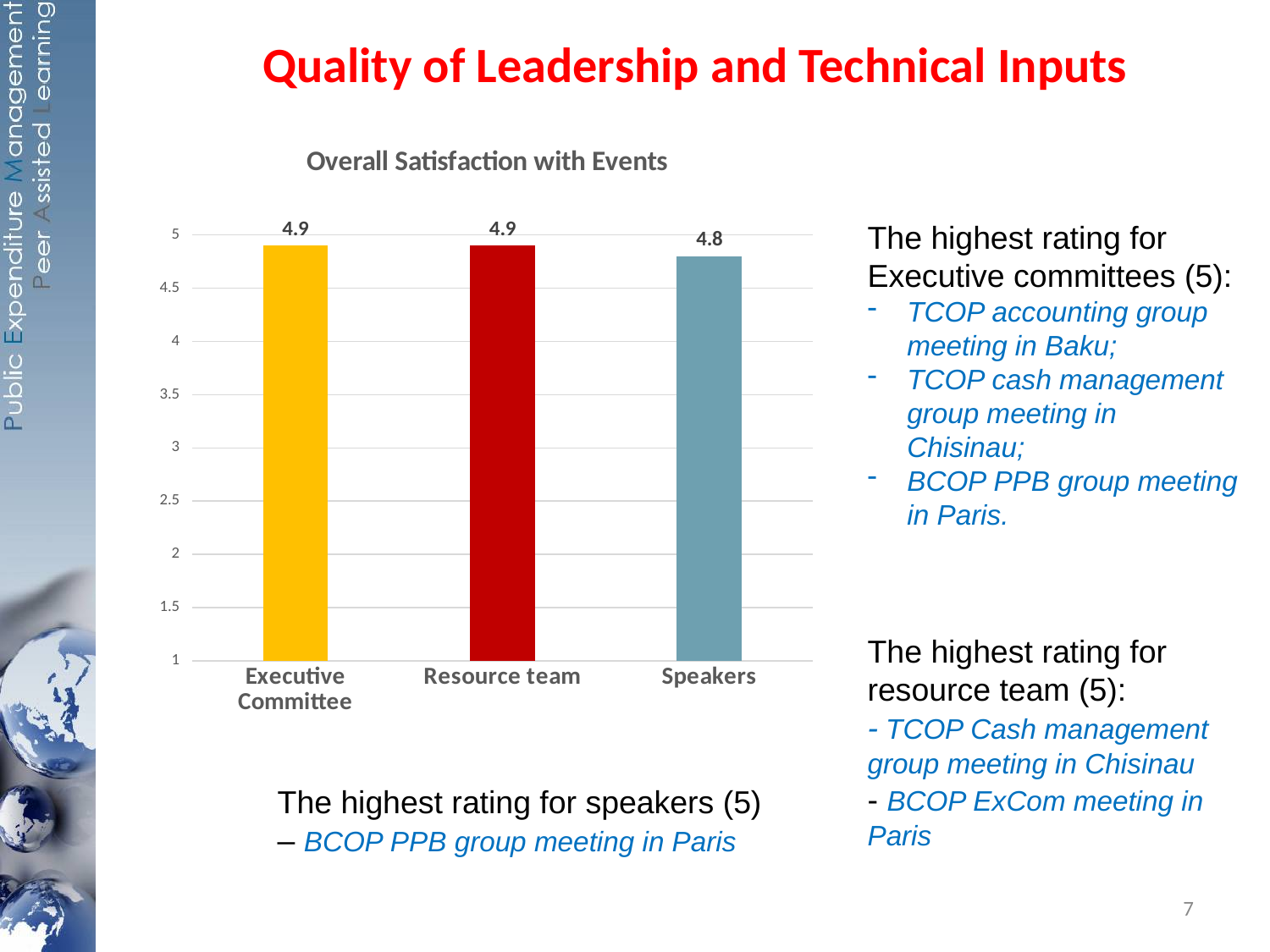
What is the value for Resource team? 4.9 What is the value for Executive Committee? 4.9 What kind of chart is shown on the slide? bar chart What is the title of the chart? Overall Satisfaction with Events How many categories are shown on the chart? 3 What colour is the bar for Resource team? red Is the value for Speakers greater or less than 4.5? greater Which is larger, the value for Resource team or the value for Speakers? Resource team What is the difference between the values for Executive Committee and Speakers? 0.1 What is the value for Speakers? 4.8 Do the values rise or fall from Resource team to Speakers? fall Which category has the lowest value? Speakers